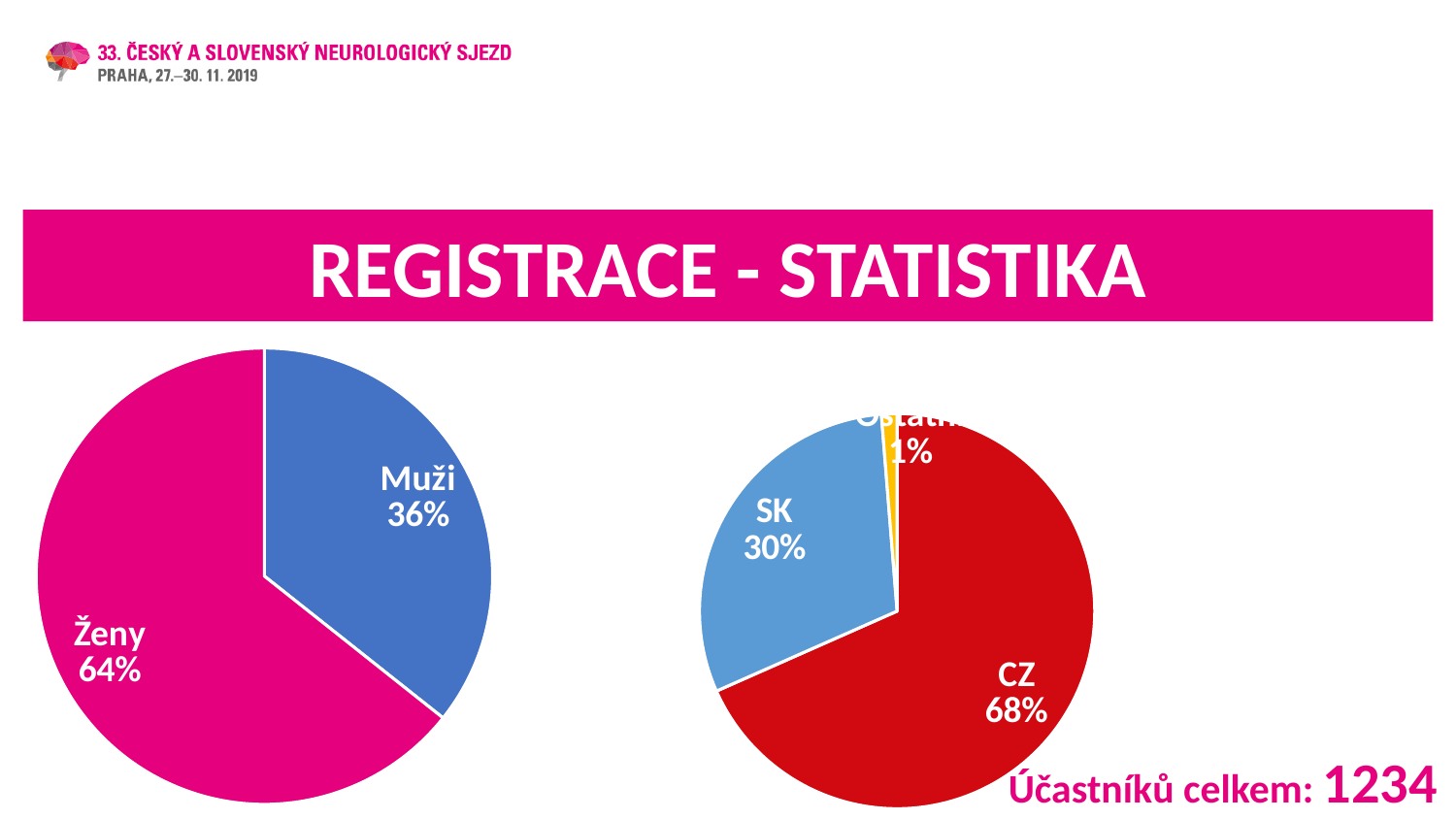
In the left pie chart, what share is labelled for Ženy? 64% In the right pie chart, which category has the largest share? CZ In the left pie chart, what share is labelled for Muži? 36% In the left pie chart, which category has the larger share? Ženy In the right pie chart, what share is labelled for CZ? 68% What kind of chart is the left chart on the slide? pie chart In the left pie chart, what is the difference in percentage points between Ženy and Muži? 28 In the right pie chart, what share is labelled for SK? 30% In the right pie chart, which is larger, CZ or SK? CZ In the right pie chart, what is the difference in percentage points between CZ and SK? 38 How many slices does the right pie chart have? 3 How many slices does the left pie chart have? 2